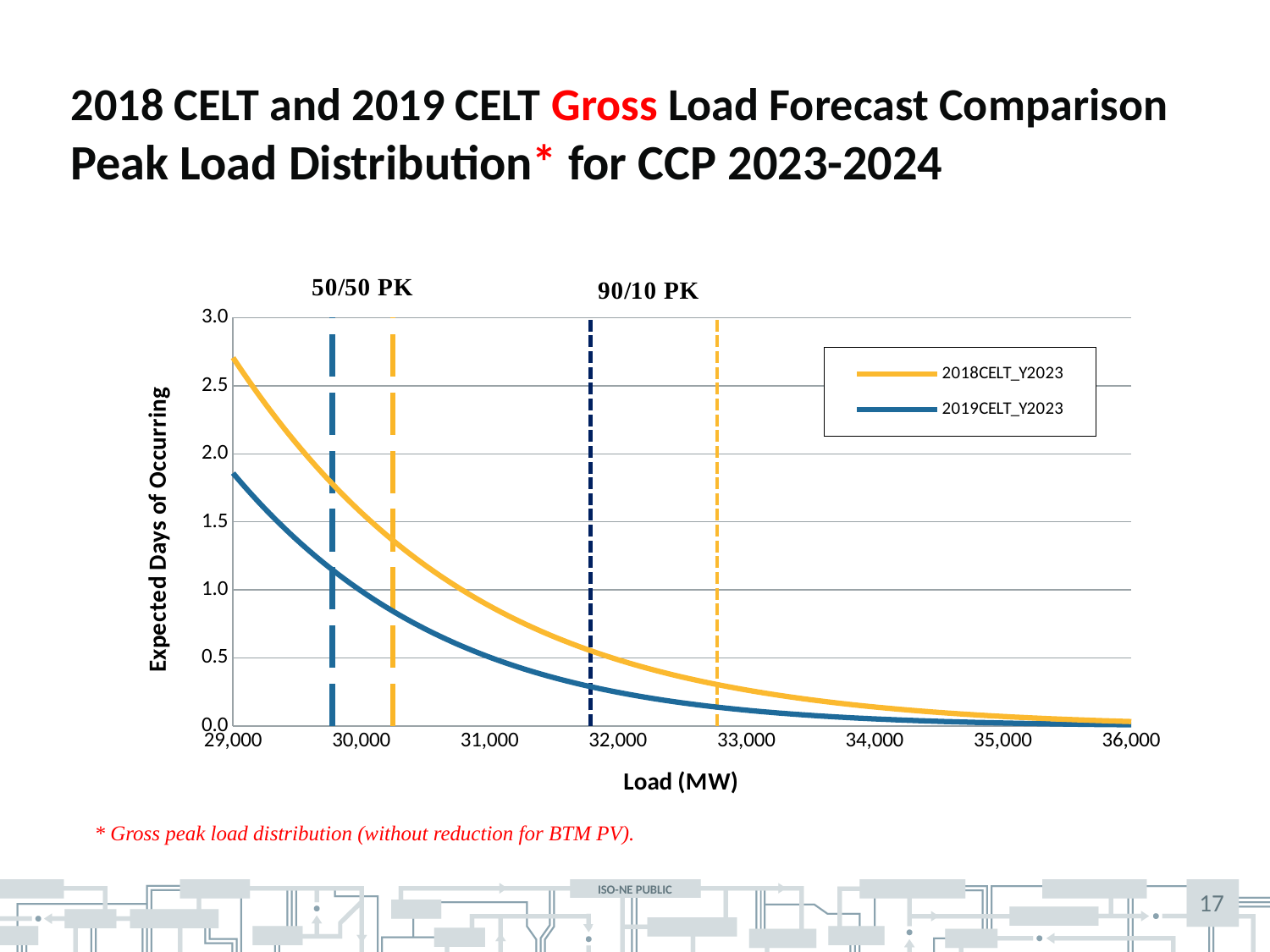
At a load of 29,000 MW, which series has the higher expected days of occurring, 2018CELT_Y2023 or 2019CELT_Y2023? 2018CELT_Y2023 What kind of chart is shown on the slide? Line chart Is the value for 2019CELT_Y2023 at 29,000 MW greater or less than 2.0? less How many tick labels are shown on the x axis? 8 Which series does the legend list first? 2018CELT_Y2023 Do the values of the 2018CELT_Y2023 series rise or fall as load increases along the x axis? Fall Is the value for 2018CELT_Y2023 at 29,000 MW greater or less than 2.5? greater What is the title of the x axis? Load (MW) How many series does the legend list? 2 Is the value for 2018CELT_Y2023 at 34,000 MW greater or less than 0.5? less Do the values of the 2019CELT_Y2023 series rise or fall as load increases along the x axis? Fall